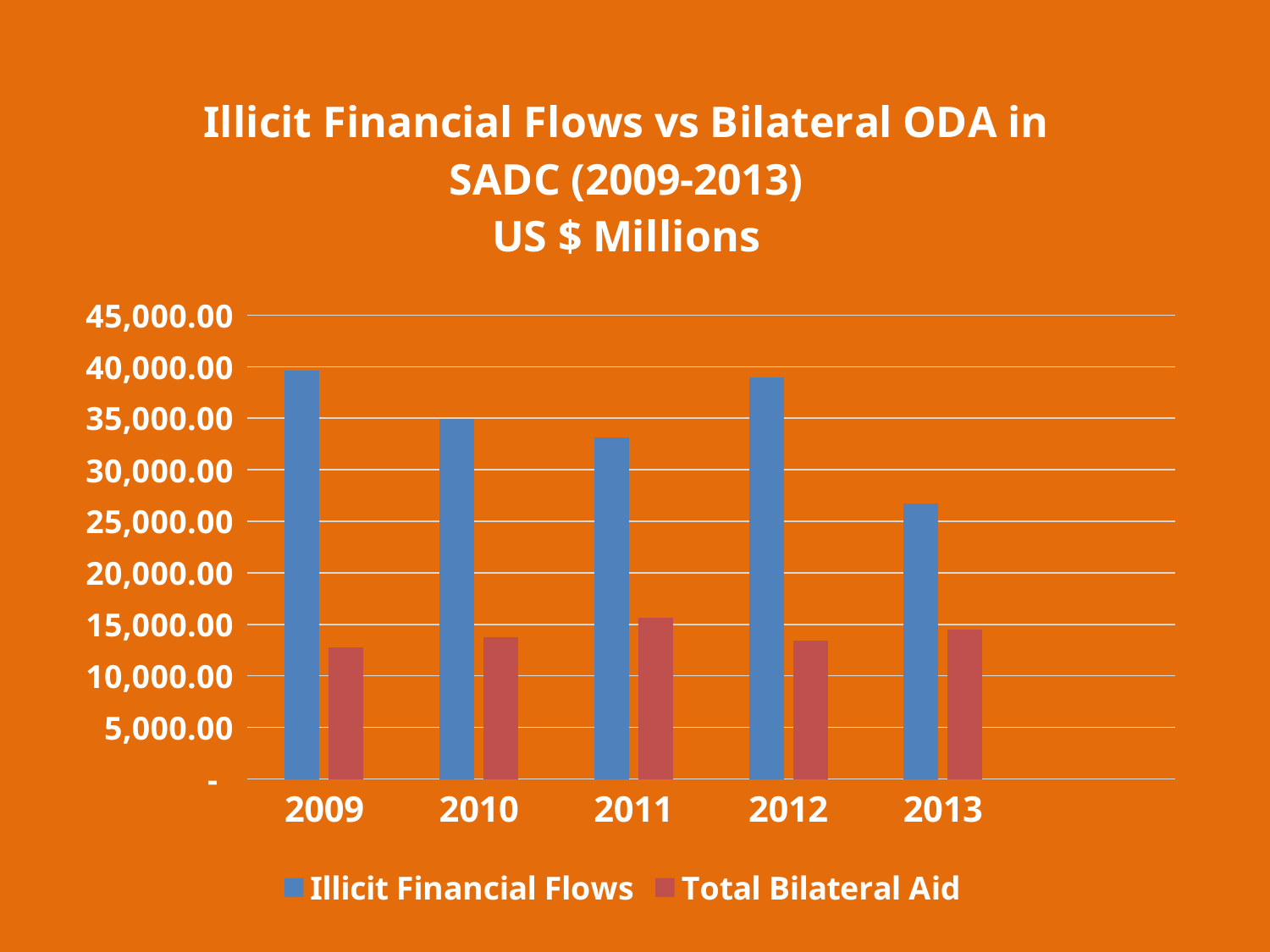
What kind of chart is shown on the slide? bar chart Is the value for Total Bilateral Aid in 2009 greater or less than 15,000.00? less How many series does the legend list? 2 Is the value for Illicit Financial Flows in 2013 greater or less than 30,000.00? less What unit is stated in the chart title? US $ Millions How many years are shown on the x axis? 5 Is the value for Illicit Financial Flows in 2009 greater or less than 35,000.00? greater Do the Illicit Financial Flows values rise or fall from 2012 to 2013? fall Which is larger, Illicit Financial Flows in 2011 or in 2012? 2012 Which year has the lowest value for Illicit Financial Flows? 2013 Which year has the highest value for Total Bilateral Aid? 2011